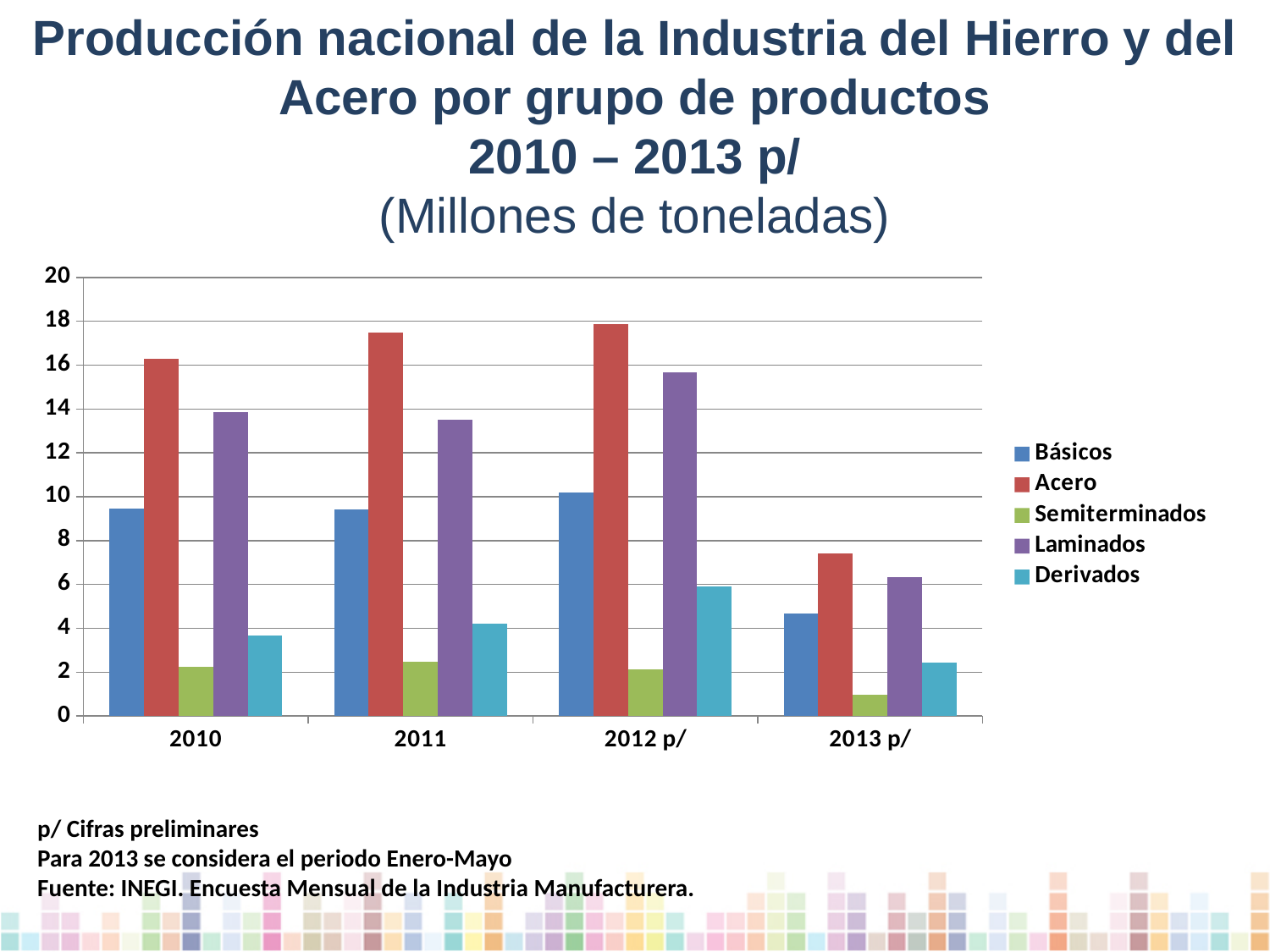
Do the Derivados values rise or fall from 2010 to 2012 p/? rise How many series does the legend list? 5 What colour represents the Acero series in the legend? red How many year categories are shown on the x axis? 4 Which series has the lowest bar in 2013 p/? Semiterminados Is the value for Semiterminados in 2013 p/ greater or less than 2? less Which is larger in 2013 p/, Acero or Laminados? Acero In which year is the Acero bar the highest? 2012 p/ Is the value for Acero in 2011 greater or less than 16? greater Which is larger, Básicos in 2012 p/ or Básicos in 2013 p/? Básicos in 2012 p/ What kind of chart is shown on the slide? bar chart Is the value for Laminados in 2012 p/ greater or less than 14? greater